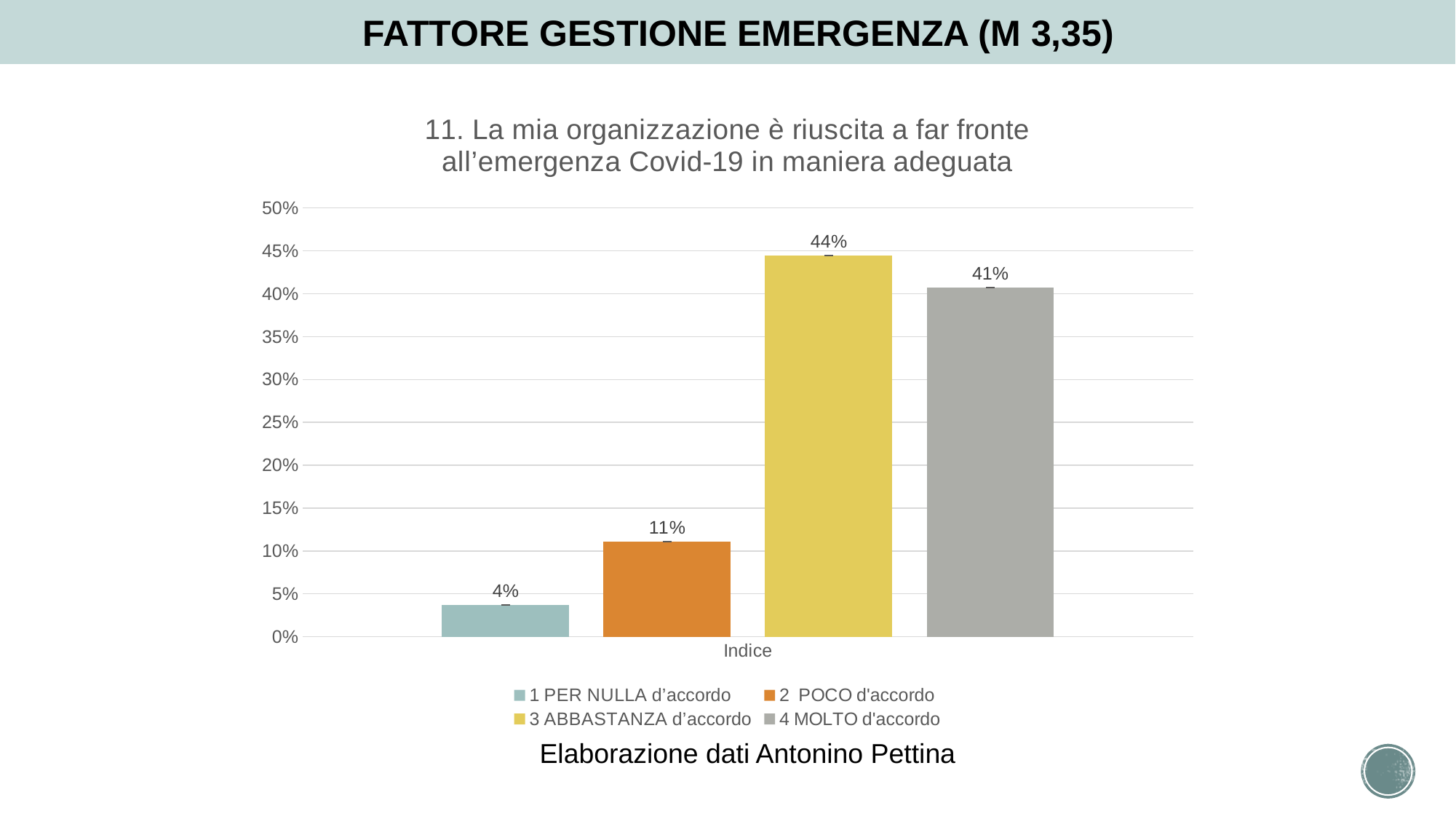
How many series does the legend list? 4 Which series has the lowest value? 1 PER NULLA d'accordo Which series has the highest value? 3 ABBASTANZA d'accordo What is the difference between the values for "3 ABBASTANZA d'accordo" and "4 MOLTO d'accordo"? 3% What is the label on the x axis of the chart? Indice What is the value for "4 MOLTO d'accordo"? 41% Which is larger, the value for "2 POCO d'accordo" or the value for "1 PER NULLA d'accordo"? 2 POCO d'accordo What is the value for "2 POCO d'accordo"? 11% What kind of chart is shown on the slide? bar chart What is the value for "3 ABBASTANZA d'accordo"? 44% What is the value for "1 PER NULLA d'accordo"? 4% Is the value for "4 MOLTO d'accordo" greater or less than 35%? greater